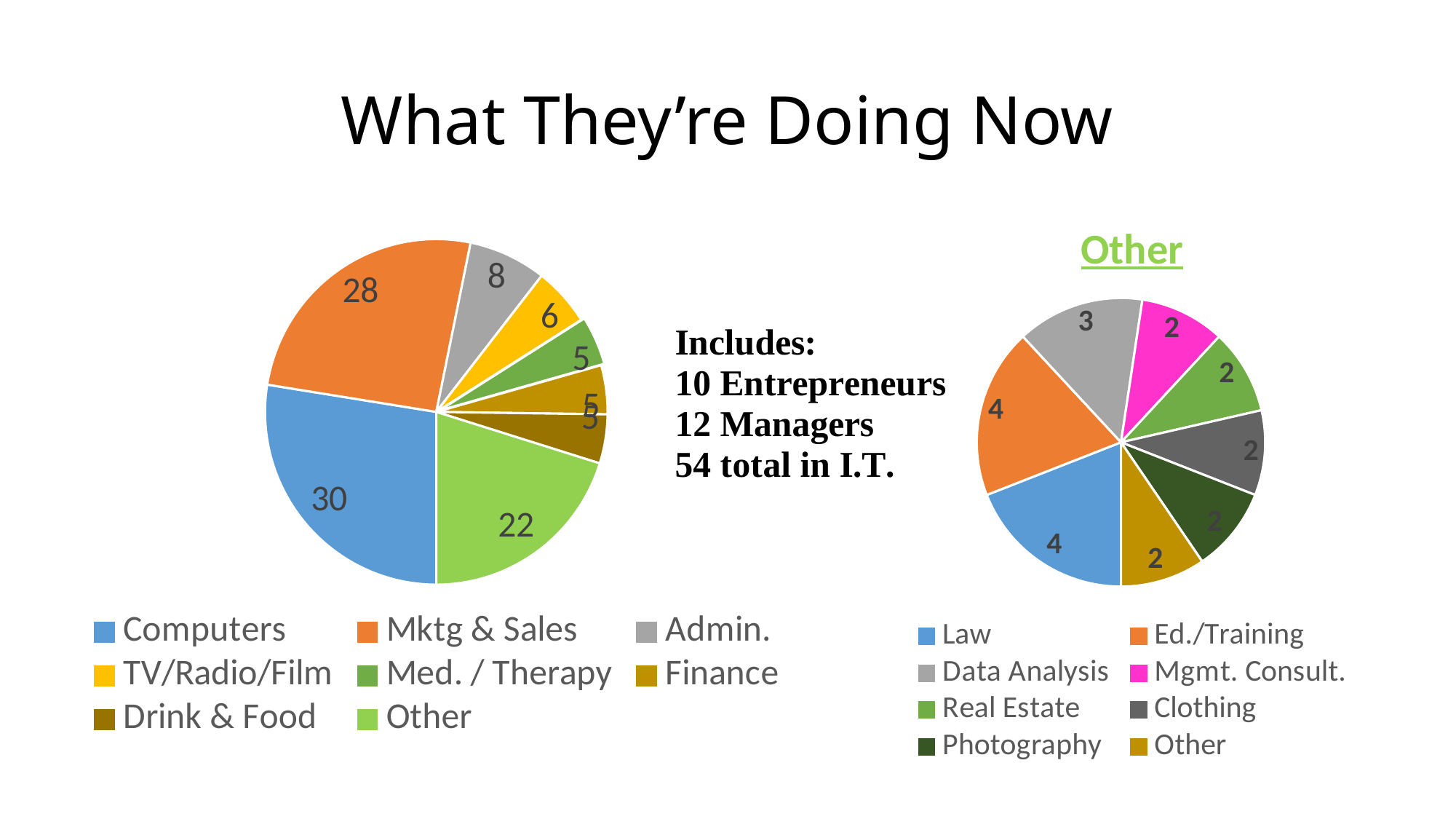
In the 'Other' pie chart on the right, what is the value for Data Analysis? 3 In the left pie chart, which category has the largest value? Computers How many categories does the left pie chart show? 8 In the 'Other' pie chart on the right, which is larger: Ed./Training or Mgmt. Consult.? Ed./Training In the left pie chart, what is the value for Computers? 30 In the 'Other' pie chart on the right, what is the value for Law? 4 In the left pie chart, which is larger: Admin. or TV/Radio/Film? Admin. What kind of chart is the left chart on the slide? Pie chart In the left pie chart, what is the difference between the values for Computers and Other? 8 In the left pie chart, what is the value for Med. / Therapy? 5 What is the title of the pie chart on the right? Other In the left pie chart, what is the value for Mktg & Sales? 28